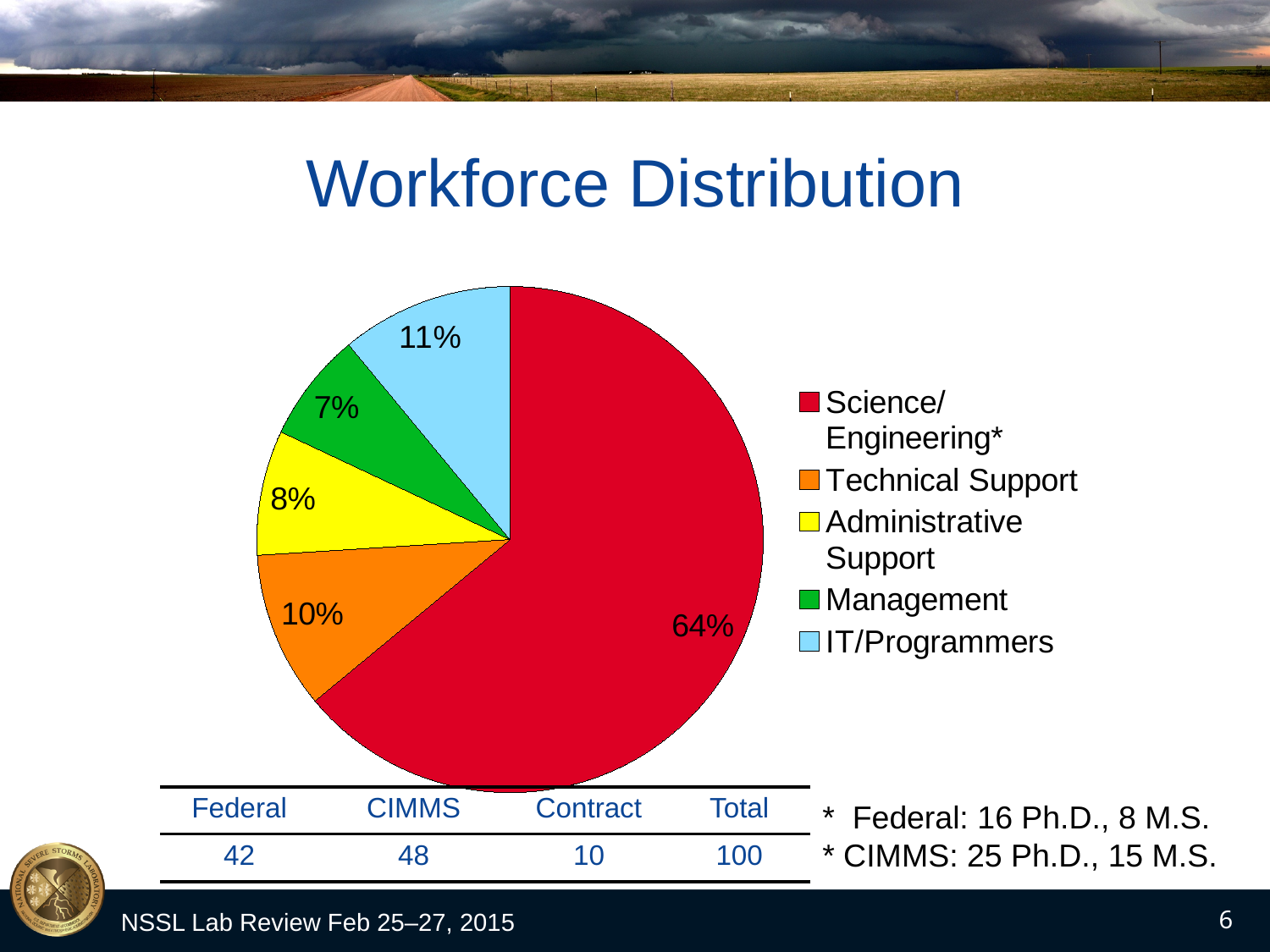
Which is larger, the share for Technical Support or the share for Administrative Support? Technical Support What share of the workforce is Science/Engineering*? 64% Which category has the largest share of the pie? Science/Engineering* What share of the workforce is Technical Support? 10% What kind of chart is shown on the slide? pie chart What is the difference in percentage points between Science/Engineering* and IT/Programmers? 53 What share of the workforce is Management? 7% How many categories does the legend list? 5 What is the title of the chart? Workforce Distribution What share of the workforce is Administrative Support? 8% What share of the workforce is IT/Programmers? 11% Which category has the smallest share of the pie? Management